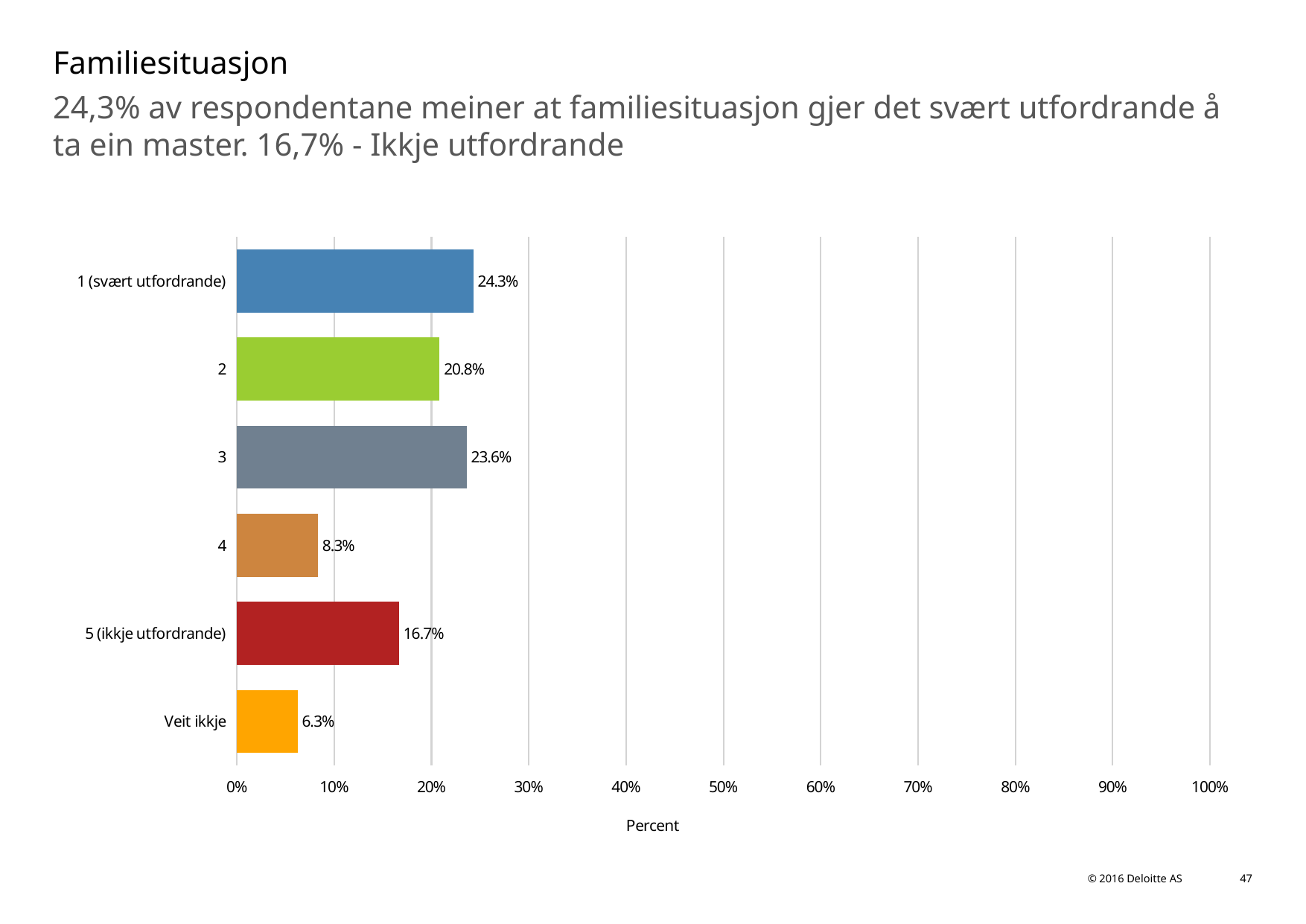
What is the value for "Veit ikkje"? 6.3% What is the difference between the values for "2" and "4"? 12.5% Which category has the lowest value? Veit ikkje How many categories are shown in the chart? 6 What is the value for "1 (svært utfordrande)"? 24.3% What is the value for category "4"? 8.3% Is the value for "2" greater or less than 30%? less What is the value for "5 (ikkje utfordrande)"? 16.7% Which category has the highest value? 1 (svært utfordrande) Which is larger, the value for "3" or the value for "5 (ikkje utfordrande)"? 3 What kind of chart is shown on the slide? bar chart What is the label of the horizontal axis? Percent